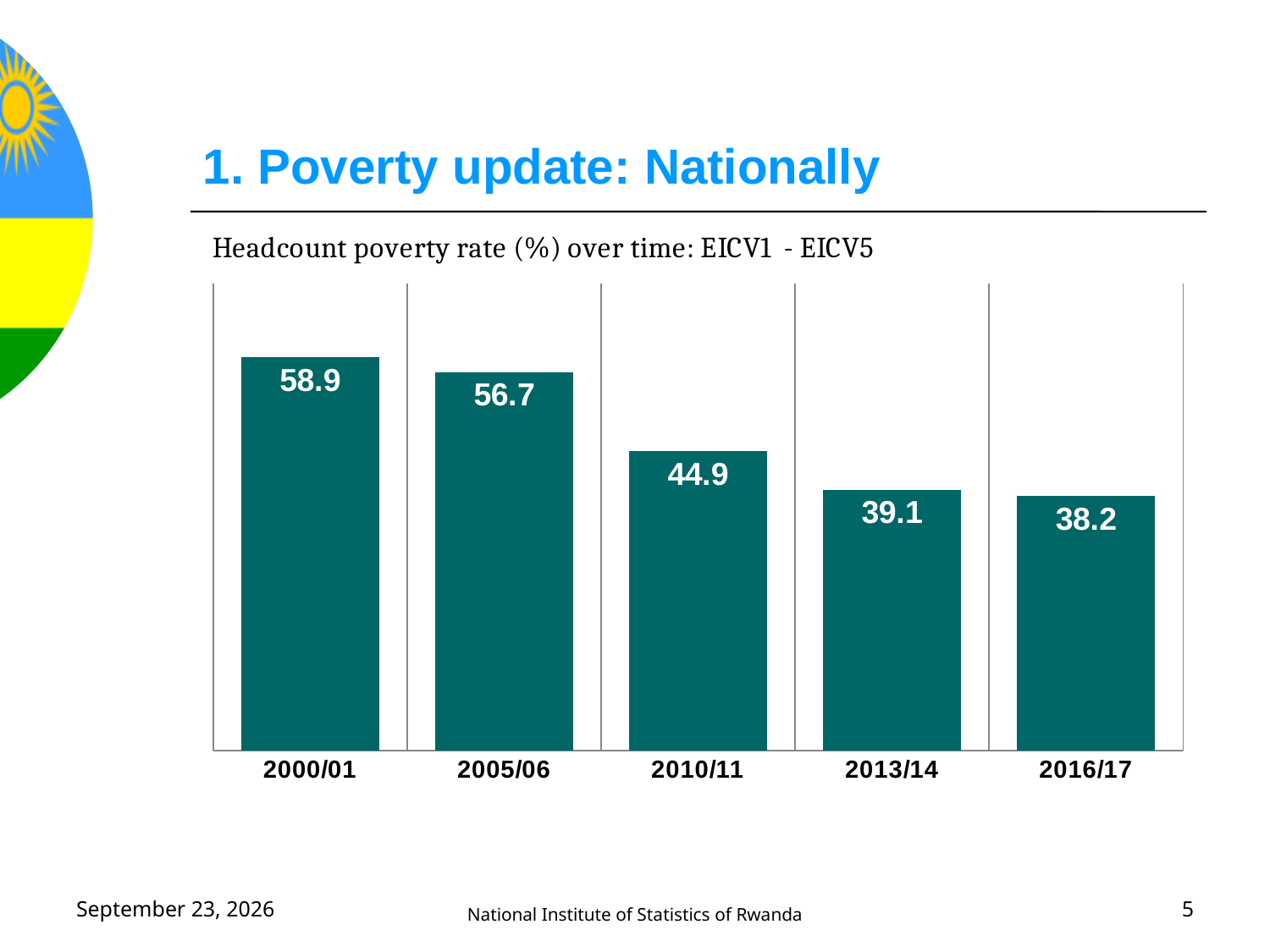
What is the difference between the poverty rate in 2005/06 and in 2010/11? 11.8 Which survey period has the lowest headcount poverty rate? 2016/17 How many survey periods are shown on the chart? 5 Do the poverty rates rise or fall from 2000/01 to 2016/17? Fall Which survey period has the highest headcount poverty rate? 2000/01 What is the headcount poverty rate for 2010/11? 44.9 What is the headcount poverty rate for 2016/17? 38.2 Which is larger, the poverty rate in 2005/06 or in 2013/14? 2005/06 What is the difference between the poverty rate in 2000/01 and in 2016/17? 20.7 What is the title of the chart? Headcount poverty rate (%) over time: EICV1 - EICV5 What is the headcount poverty rate for 2000/01? 58.9 What kind of chart is shown on the slide? Bar chart